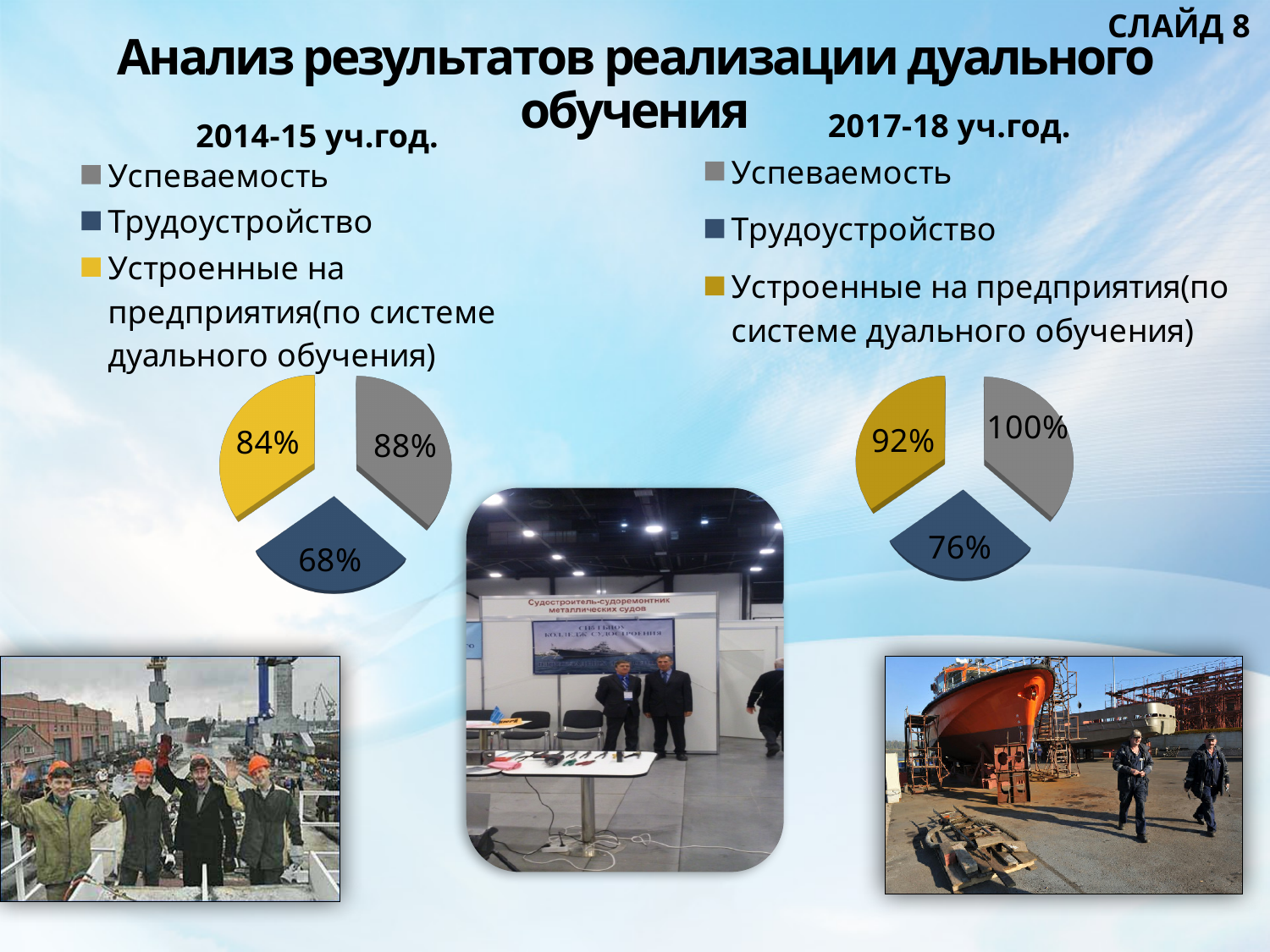
What type of chart is the 2014-15 уч.год. chart? Pie chart In the 2014-15 уч.год. chart, what colour is the Трудоустройство slice? Blue In the 2014-15 уч.год. chart, what is the difference between Успеваемость and Трудоустройство? 20% In the 2017-18 уч.год. chart, what is the value for Успеваемость? 100% In the 2014-15 уч.год. chart, what is the value for Успеваемость? 88% Which is larger: Трудоустройство in the 2014-15 уч.год. chart or Трудоустройство in the 2017-18 уч.год. chart? 2017-18 уч.год. In the 2014-15 уч.год. chart, which category has the lowest value? Трудоустройство In the 2014-15 уч.год. chart, what is the value for Трудоустройство? 68% In the 2017-18 уч.год. chart, which category has the highest value? Успеваемость In the 2017-18 уч.год. chart, what is the difference between Успеваемость and Трудоустройство? 24% How many categories does the 2017-18 уч.год. chart show? 3 In the 2017-18 уч.год. chart, what is the value for Устроенные на предприятия (по системе дуального обучения)? 92%